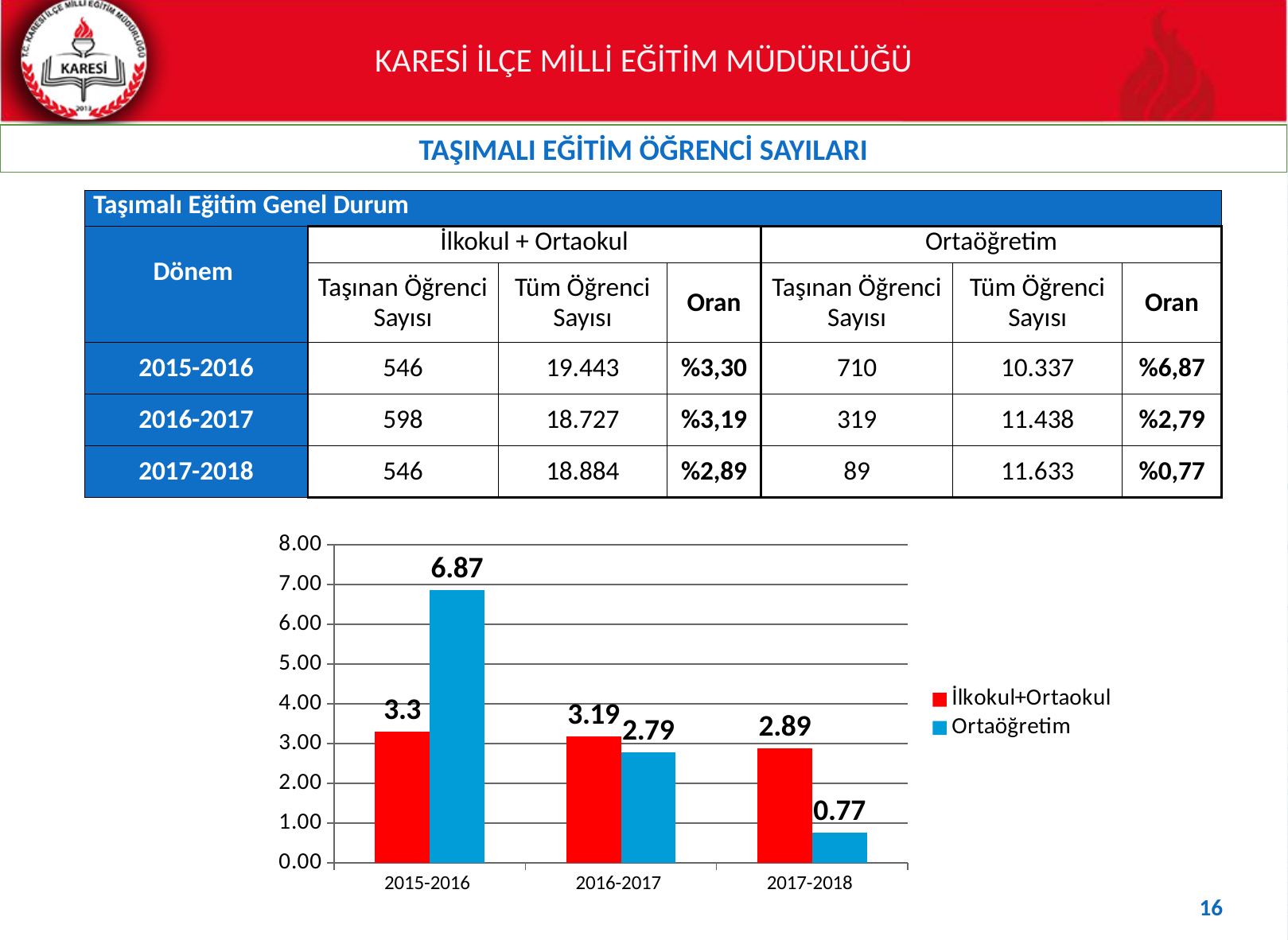
Which is larger in 2017-2018 on the chart: İlkokul+Ortaokul or Ortaöğretim? İlkokul+Ortaokul Do the Ortaöğretim values rise or fall across the periods on the chart? fall How many series does the chart legend list? 2 What kind of chart is shown on the slide? bar chart What is the value for İlkokul+Ortaokul in 2016-2017 on the chart? 3.19 What is the difference between the Ortaöğretim and İlkokul+Ortaokul values in 2015-2016 on the chart? 3.57 What is the value for Ortaöğretim in 2015-2016 on the chart? 6.87 What is the value for Ortaöğretim in 2017-2018 on the chart? 0.77 How many periods (categories) are shown on the x axis of the chart? 3 In which period is the Ortaöğretim value highest on the chart? 2015-2016 Which colour represents the Ortaöğretim series in the chart? blue In which period is the İlkokul+Ortaokul value lowest on the chart? 2017-2018